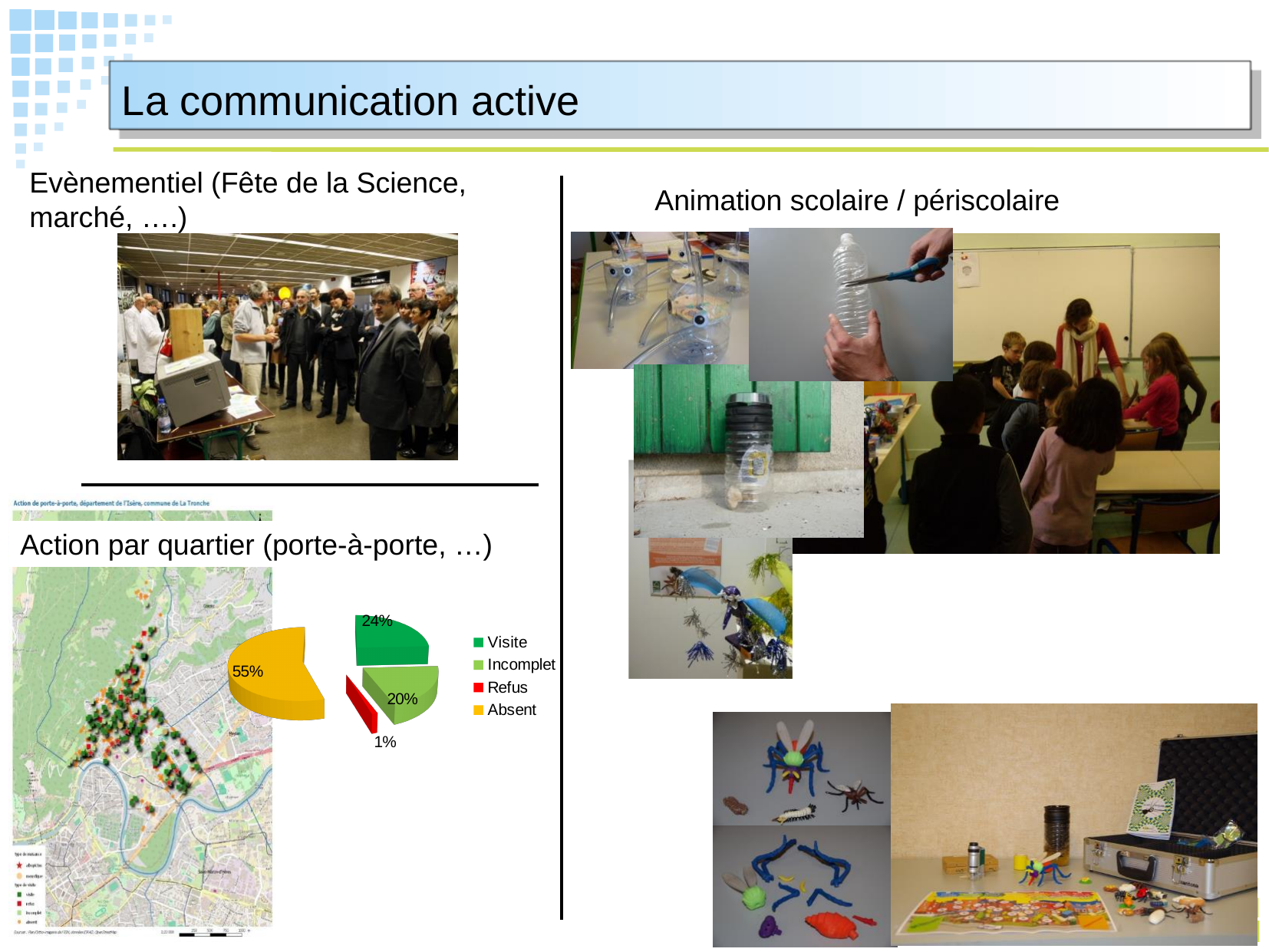
What kind of chart is shown on the slide? pie chart What is the difference in percentage points between Absent and Visite in the pie chart? 31 What share of the pie chart is Visite? 24% Which is larger in the pie chart, Visite or Incomplet? Visite What share of the pie chart is Absent? 55% Which category has the largest slice in the pie chart? Absent What share of the pie chart is Refus? 1% What share of the pie chart is Incomplet? 20% Which category has the smallest slice in the pie chart? Refus How many categories does the pie chart legend list? 4 What colour is the Absent slice in the pie chart? yellow What colour is the Refus slice in the pie chart? red